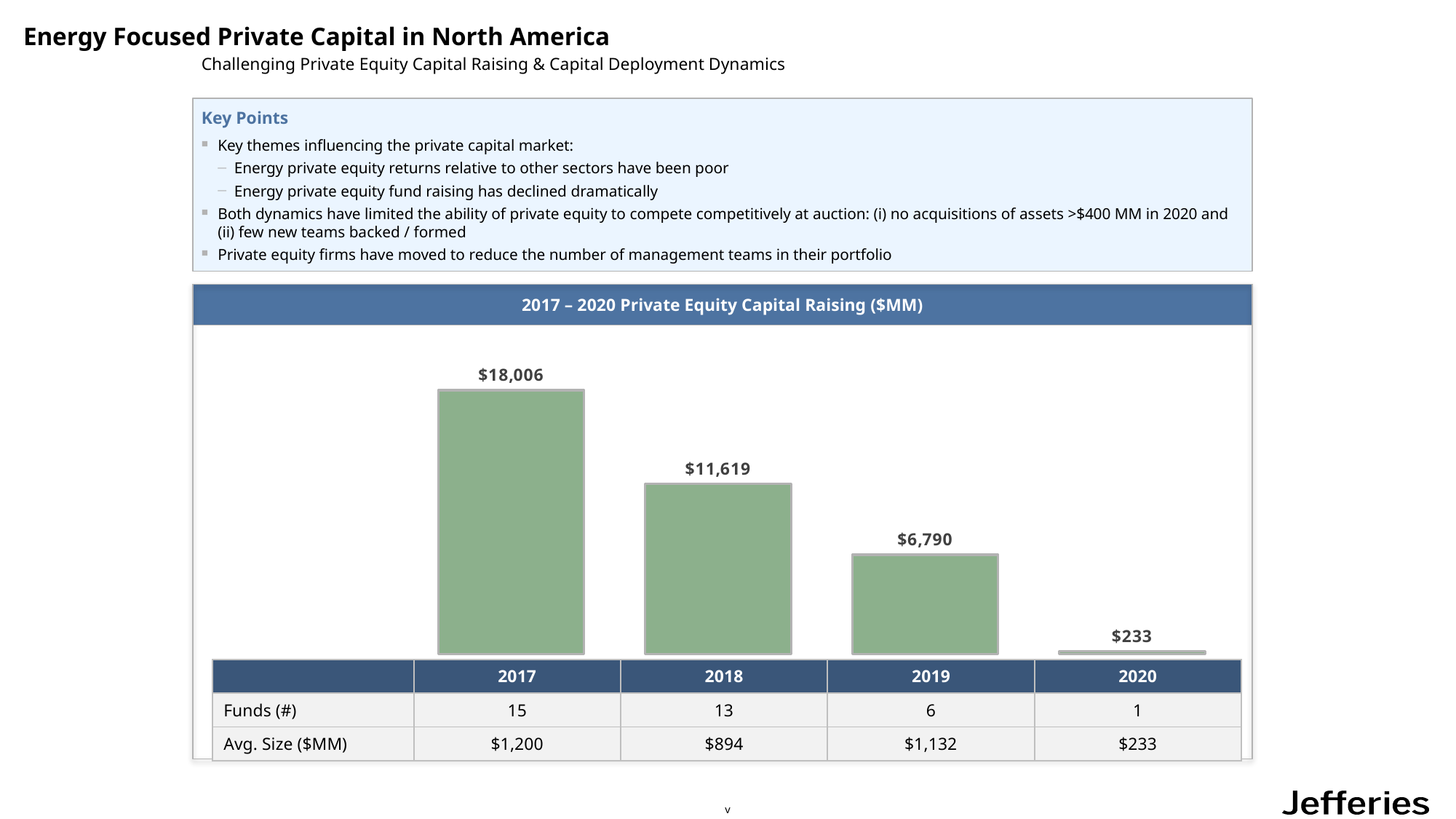
What is the value for 2019 in the Private Equity Capital Raising chart? $6,790 What is the value for 2018 in the Private Equity Capital Raising chart? $11,619 Which is larger in the Private Equity Capital Raising chart, the value for 2018 or the value for 2019? 2018 How many years are shown as bars in the Private Equity Capital Raising chart? 4 Which year has the lowest value in the Private Equity Capital Raising chart? 2020 Do the values in the Private Equity Capital Raising chart rise or fall from 2017 to 2020? Fall What is the value for 2020 in the Private Equity Capital Raising chart? $233 What is the difference between the 2017 and 2018 values in the Private Equity Capital Raising chart? $6,387 What kind of chart is the 2017 – 2020 Private Equity Capital Raising chart? Bar chart What is the value for 2017 in the 2017 – 2020 Private Equity Capital Raising chart? $18,006 What is the difference between the 2019 and 2020 values in the Private Equity Capital Raising chart? $6,557 Which year has the highest value in the Private Equity Capital Raising chart? 2017